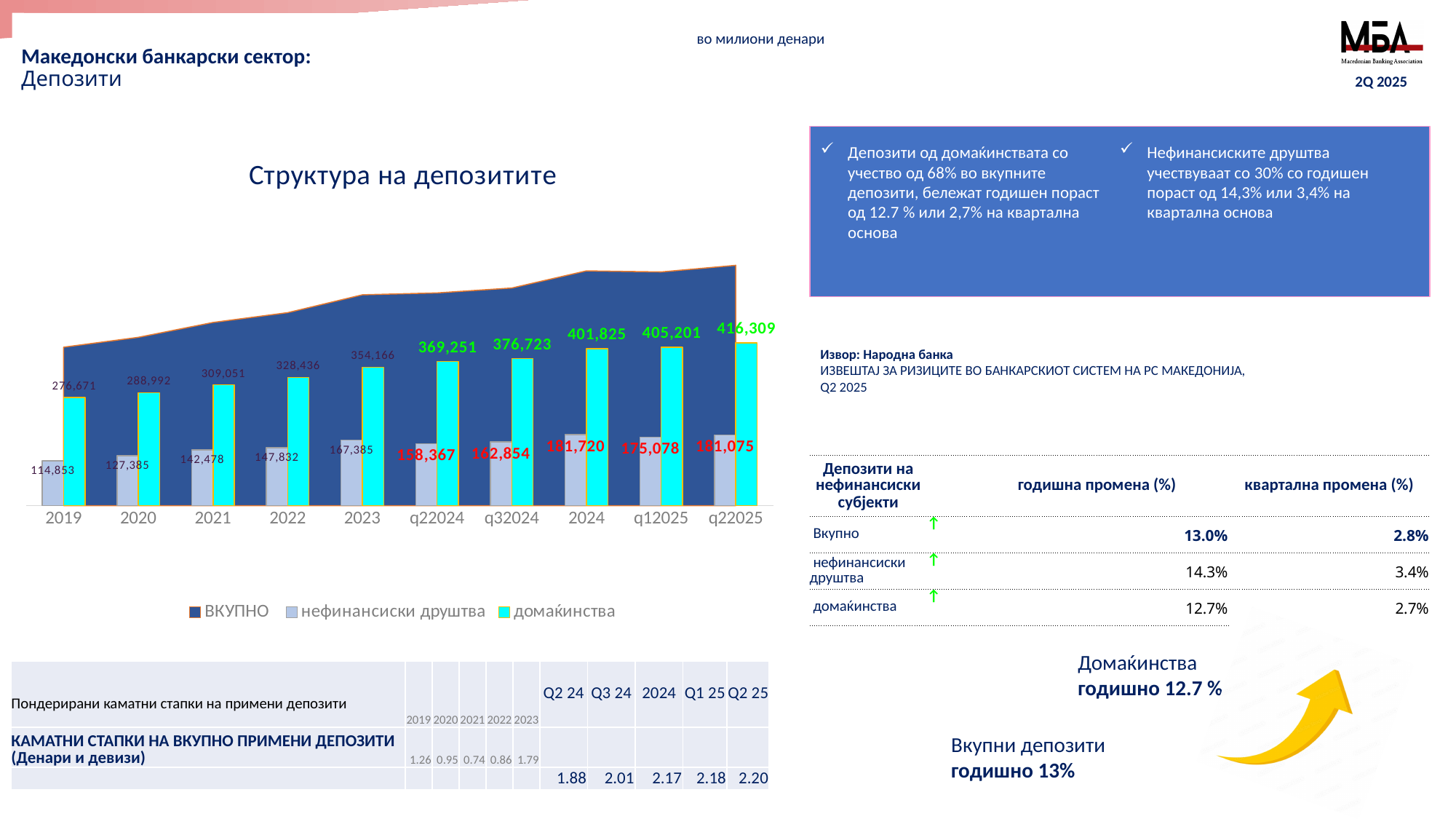
How many series does the chart legend list? 3 What is the difference between the домаќинства values for q22025 and q12025? 11,108 What is the value for домаќинства in q22025? 416,309 What is the value for нефинансиски друштва in q12025? 175,078 How many periods are shown on the x axis of the chart? 10 Do the values for домаќинства rise or fall from 2019 to q22025? rise What is the value for домаќинства in 2019? 276,671 In which period is the value for домаќинства the highest? q22025 What is the value for нефинансиски друштва in 2019? 114,853 Which is larger for нефинансиски друштва: the value for 2023 or for q22024? 2023 What is the difference between the домаќинства values for 2020 and 2019? 12,321 In which period is the value for нефинансиски друштва the lowest? 2019